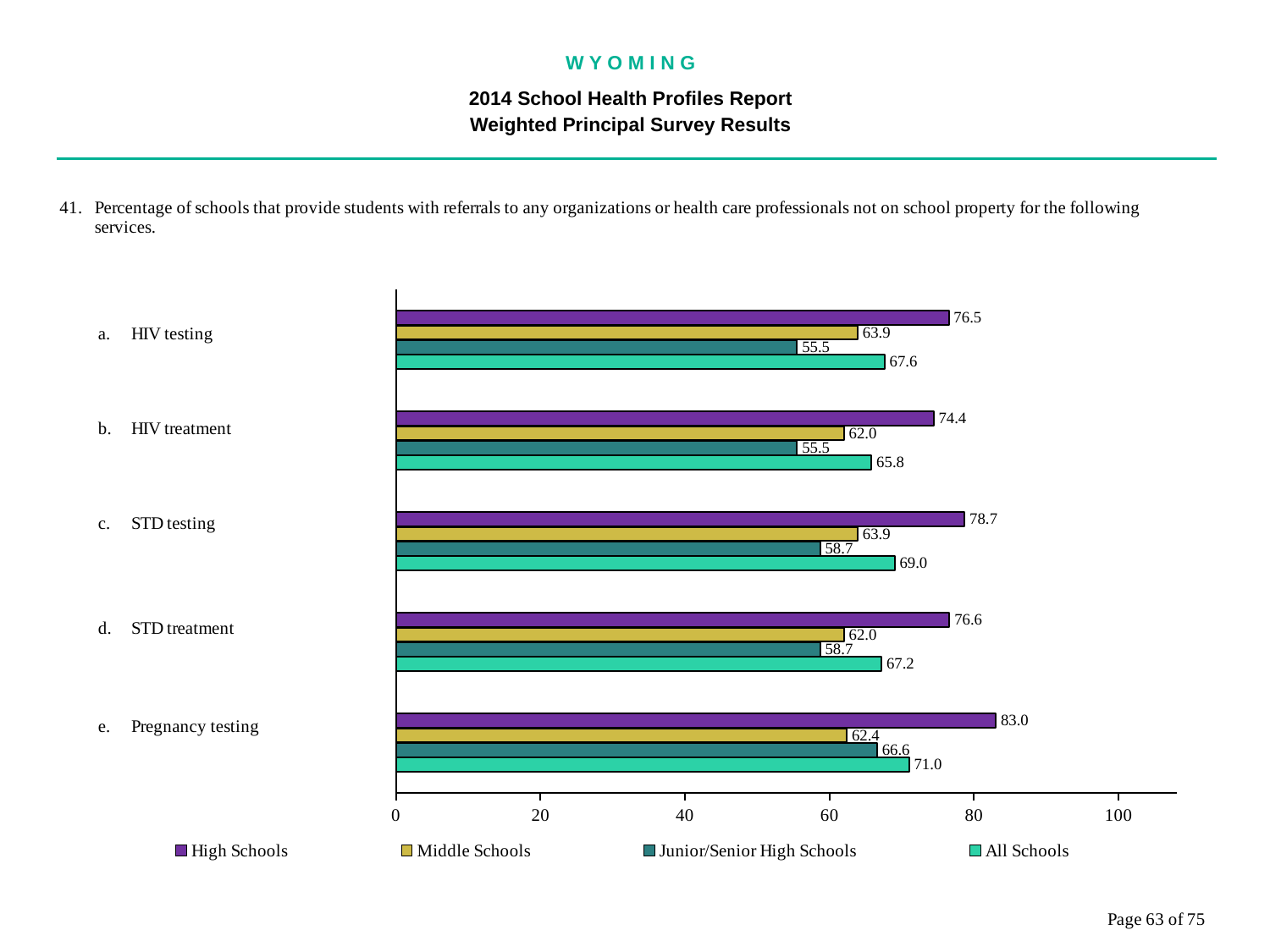
Is the value for High Schools for STD testing greater or less than 80? less What is the value for Middle Schools for STD treatment? 62.0 What is the value for High Schools for Pregnancy testing? 83.0 Which is larger for Pregnancy testing: the Middle Schools value or the Junior/Senior High Schools value? Junior/Senior High Schools Which service has the lowest value for All Schools? HIV treatment What is the value for All Schools for STD testing? 69.0 What is the value for Junior/Senior High Schools for HIV treatment? 55.5 How many series does the legend list? 4 How many services are listed on the chart? 5 What kind of chart is shown on the slide? bar chart What is the difference between the High Schools and Middle Schools values for HIV testing? 12.6 Which service has the highest value for High Schools? Pregnancy testing